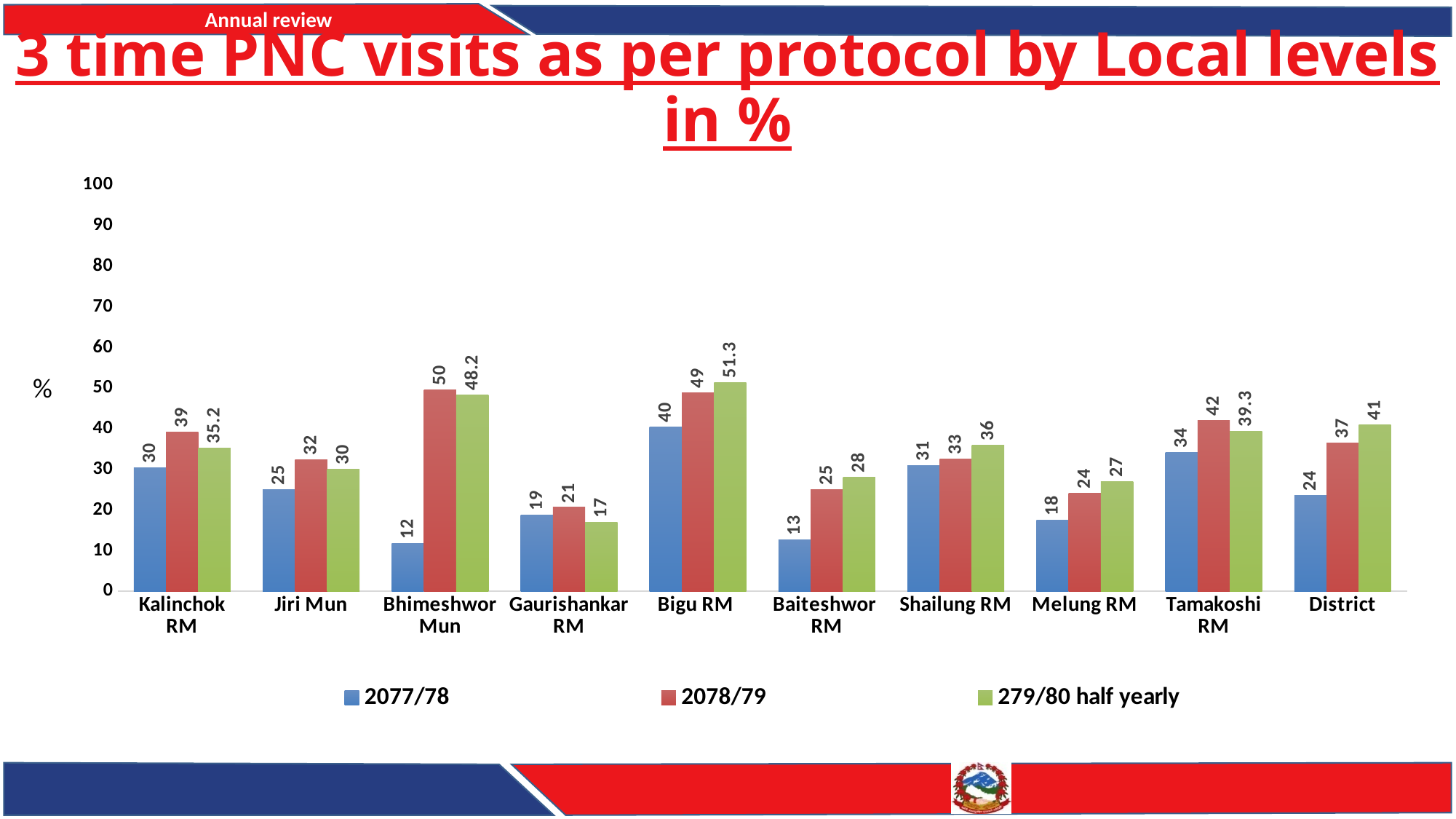
How many series does the legend list? 3 What is the difference between the 2078/79 and 2077/78 values for Bhimeshwor Mun? 38 What is the value for Bigu RM in the 279/80 half yearly series? 51.3 What kind of chart is shown on the slide? Bar chart Which local level has the highest value in the 2078/79 series? Bhimeshwor Mun How many local levels (categories) are shown on the x axis? 10 Which is larger for Tamakoshi RM: the 2078/79 value or the 279/80 half yearly value? 2078/79 What is the value for District in the 2078/79 series? 37 Which local level has the lowest value in the 279/80 half yearly series? Gaurishankar RM Do the values for Gaurishankar RM rise or fall from 2078/79 to 279/80 half yearly? Fall What is the value for Bhimeshwor Mun in the 2077/78 series? 12 What colour represents the 2077/78 series in the legend? Blue